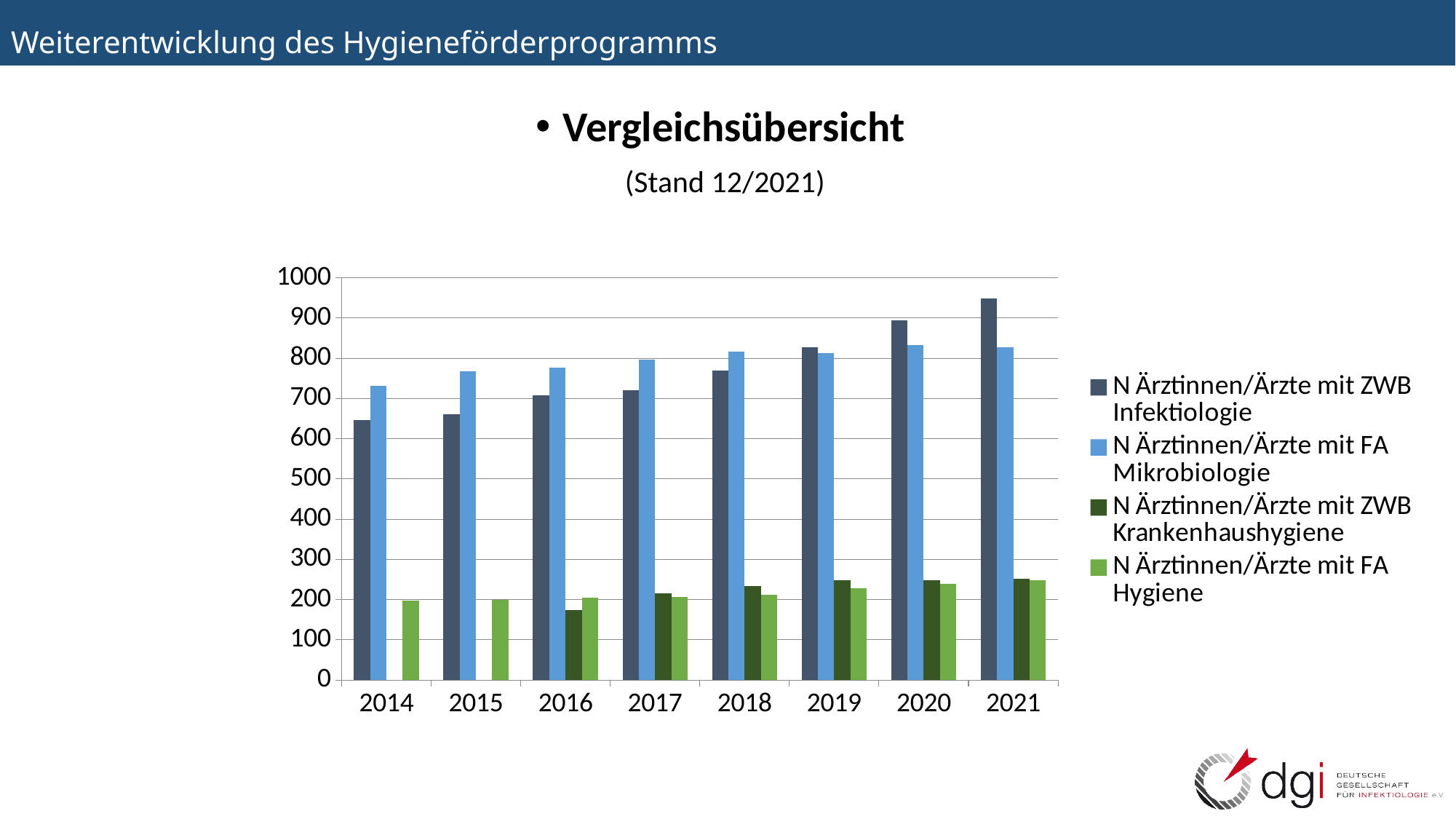
What kind of chart is shown on the slide? bar chart In which year is the value for N Ärztinnen/Ärzte mit ZWB Infektiologie lowest? 2014 What is the first year in which a bar for N Ärztinnen/Ärzte mit ZWB Krankenhaushygiene appears? 2016 Is the value for N Ärztinnen/Ärzte mit ZWB Krankenhaushygiene in 2016 greater or less than 200? less In which year is the value for N Ärztinnen/Ärzte mit ZWB Infektiologie highest? 2021 Is the value for N Ärztinnen/Ärzte mit ZWB Infektiologie in 2021 greater or less than 900? greater Is the value for N Ärztinnen/Ärzte mit FA Mikrobiologie in 2014 greater or less than 800? less Do the values for N Ärztinnen/Ärzte mit ZWB Infektiologie rise or fall from 2014 to 2021? rise How many years are shown on the x axis? 8 In 2014, which is larger: N Ärztinnen/Ärzte mit ZWB Infektiologie or N Ärztinnen/Ärzte mit FA Mikrobiologie? N Ärztinnen/Ärzte mit FA Mikrobiologie How many series does the legend list? 4 In 2021, which is larger: N Ärztinnen/Ärzte mit ZWB Infektiologie or N Ärztinnen/Ärzte mit FA Mikrobiologie? N Ärztinnen/Ärzte mit ZWB Infektiologie